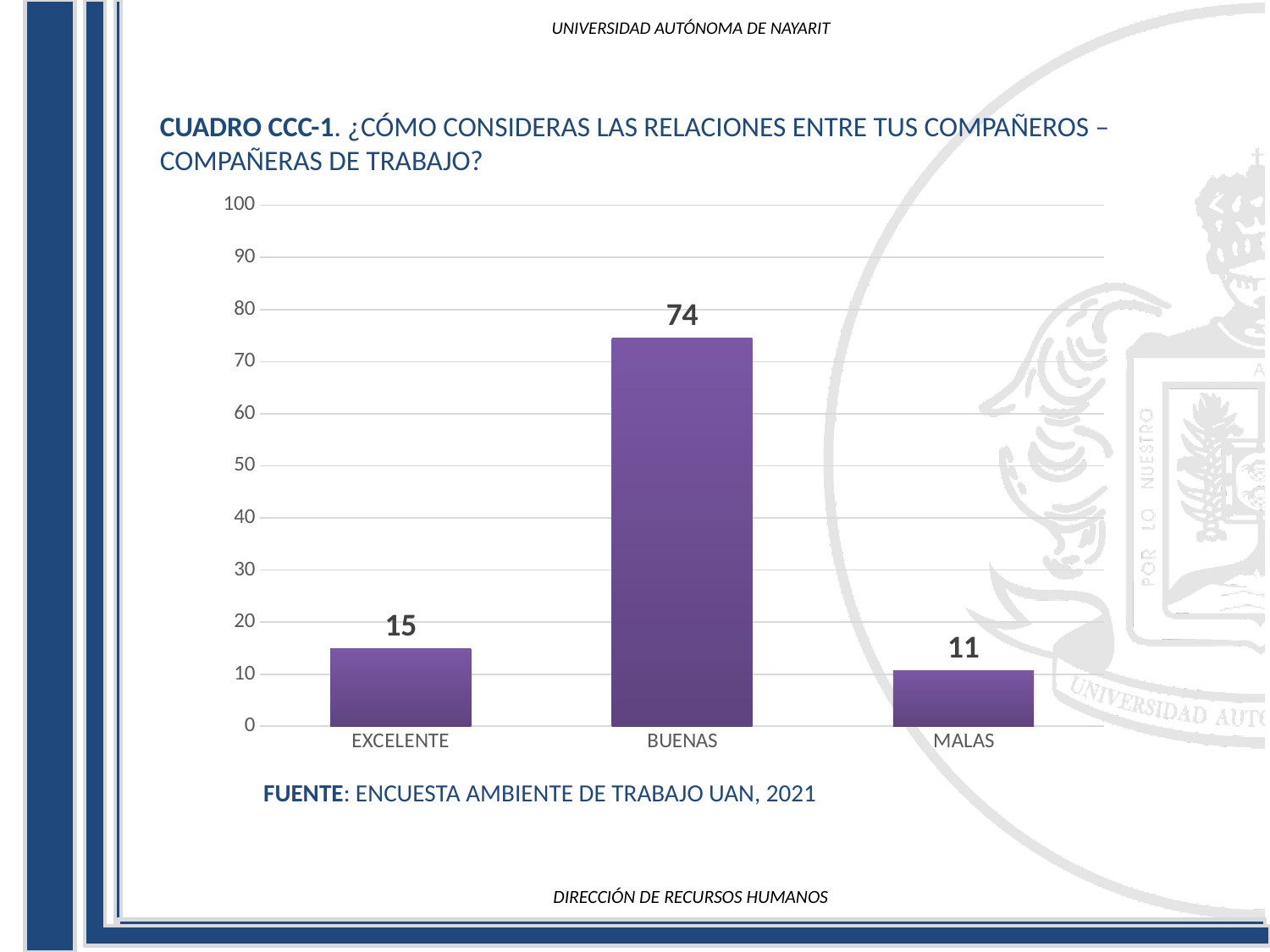
What is the source cited below the chart? ENCUESTA AMBIENTE DE TRABAJO UAN, 2021 What is the value for MALAS? 11 Which category has the highest value? BUENAS What is the value for EXCELENTE? 15 What kind of chart is shown on the slide? bar chart What is the difference between the values for BUENAS and EXCELENTE? 59 What is the value for BUENAS? 74 Which is larger, the value for EXCELENTE or the value for MALAS? EXCELENTE Which category has the lowest value? MALAS Is the value for BUENAS greater or less than 70? greater How many categories are shown on the x axis? 3 What is the difference between the values for EXCELENTE and MALAS? 4